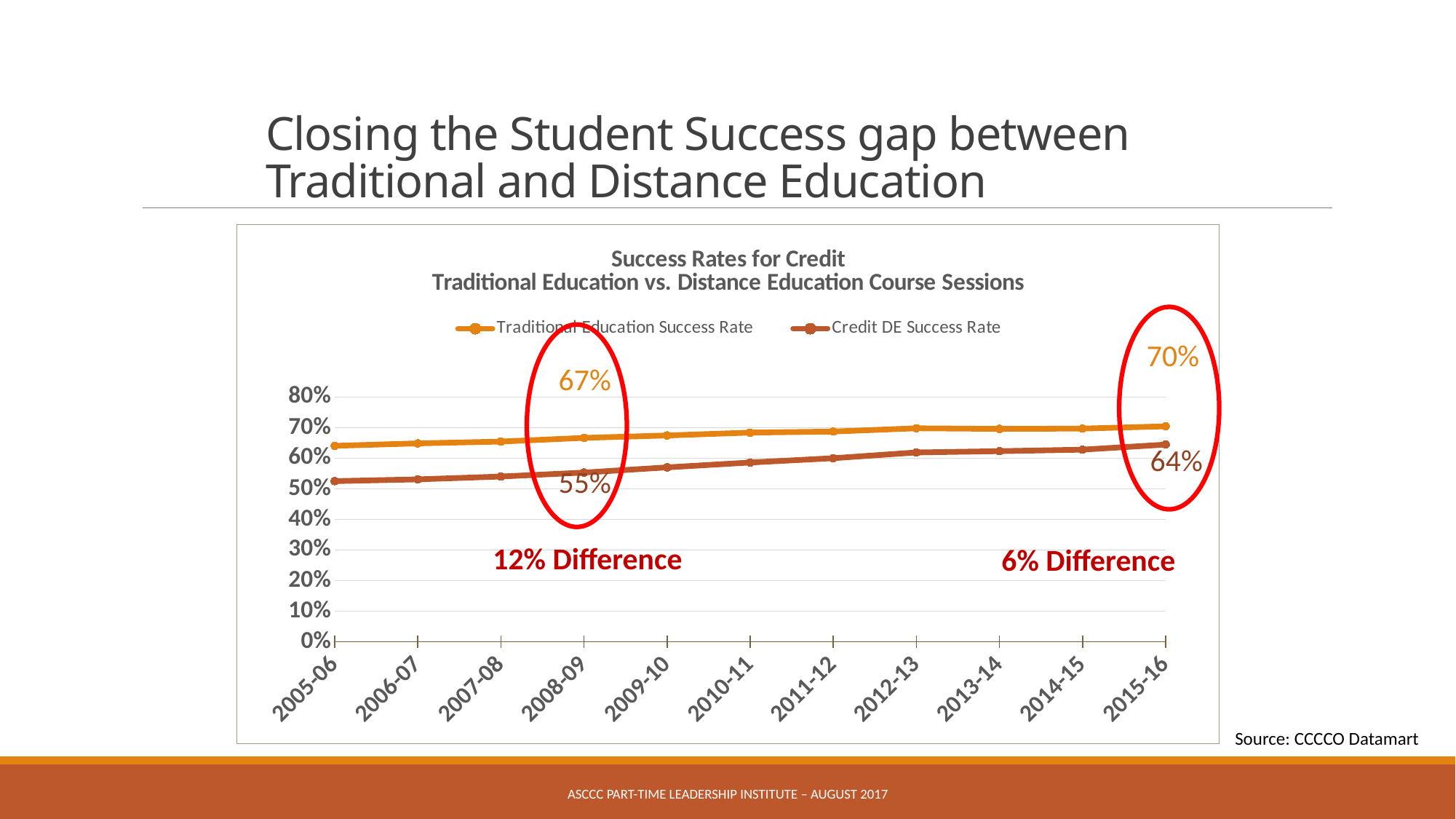
Does the Credit DE Success Rate rise or fall from 2005-06 to 2015-16? rise What is the Traditional Education Success Rate in 2008-09? 67% Is the Credit DE Success Rate in 2005-06 greater or less than 60%? less How many series does the chart legend list? 2 What is the Credit DE Success Rate in 2015-16? 64% What kind of chart is shown on the slide? line chart What is the title of the chart? Success Rates for Credit Traditional Education vs. Distance Education Course Sessions Which series has the higher value in 2008-09, Traditional Education Success Rate or Credit DE Success Rate? Traditional Education Success Rate What is the Traditional Education Success Rate in 2015-16? 70% How many academic years are plotted along the x axis? 11 What is the Credit DE Success Rate in 2008-09? 55% What is the difference between the Traditional Education Success Rate and the Credit DE Success Rate in 2015-16? 6%